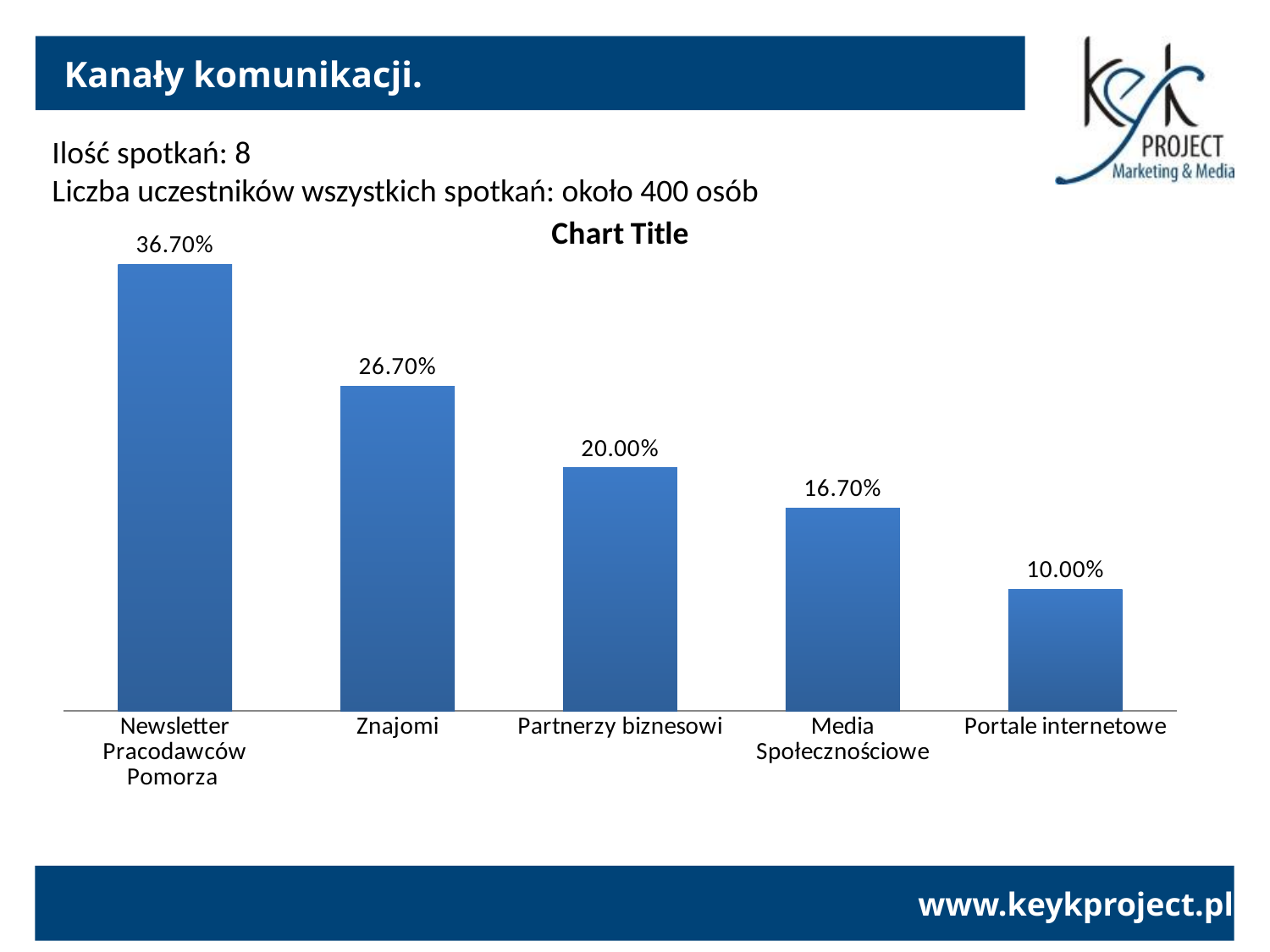
What is the value for Znajomi? 26.70% What is the value for Partnerzy biznesowi? 20.00% What is the difference between the values for Newsletter Pracodawców Pomorza and Znajomi? 10.00% What is the value for Media Społecznościowe? 16.70% How many categories are shown in the chart? 5 Which category has the highest value? Newsletter Pracodawców Pomorza What is the value for Portale internetowe? 10.00% Do the values rise or fall from left to right along the x axis? Fall What is the value for Newsletter Pracodawców Pomorza? 36.70% Which is larger, the value for Partnerzy biznesowi or the value for Media Społecznościowe? Partnerzy biznesowi What kind of chart is shown on the slide? Bar chart Which category has the lowest value? Portale internetowe